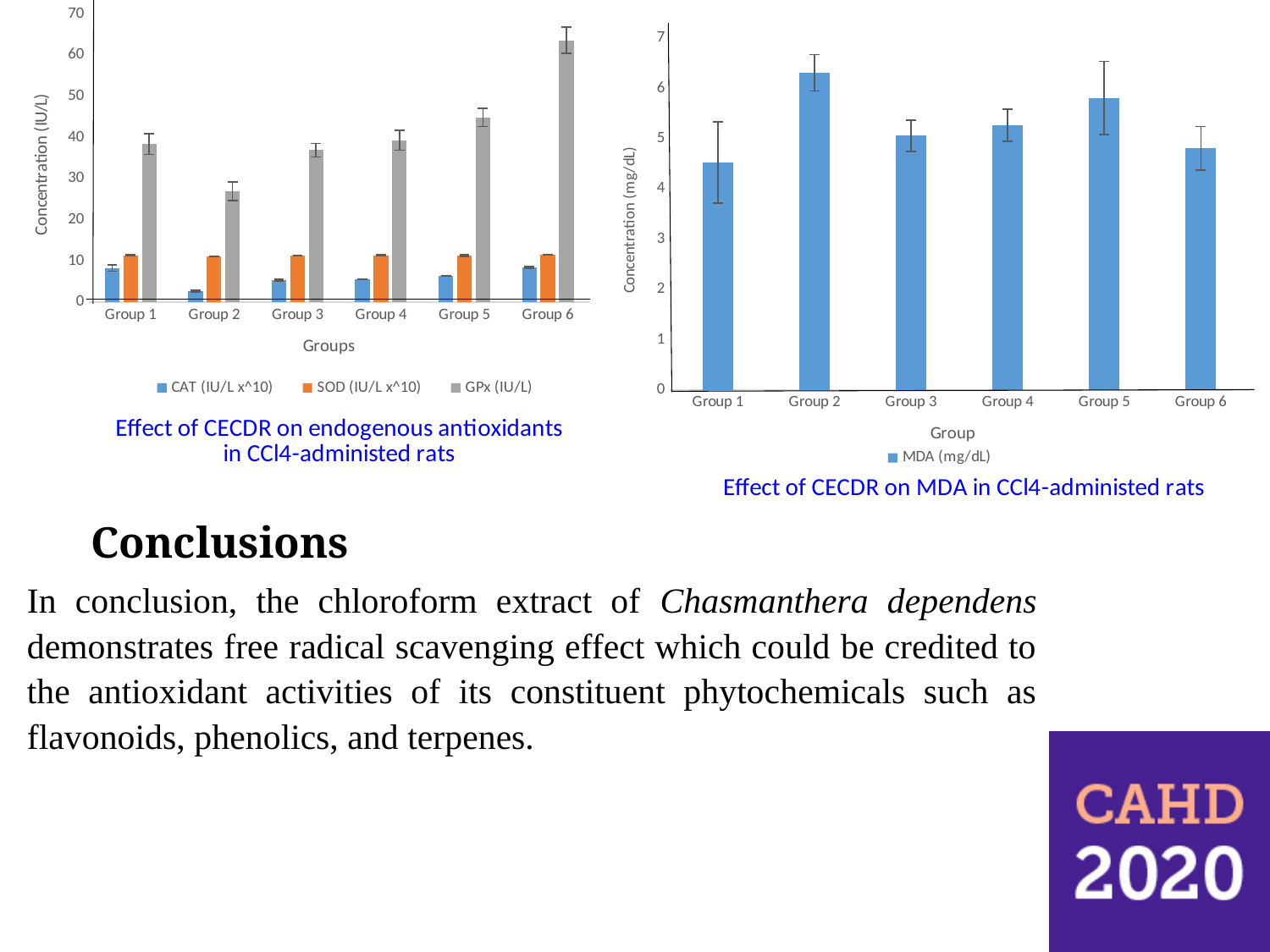
In the 'Effect of CECDR on MDA in CCl4-administed rats' chart, which group has the highest MDA (mg/dL) value? Group 2 In the 'Effect of CECDR on endogenous antioxidants in CCl4-administed rats' chart, which group has the lowest GPx (IU/L) value? Group 2 In the 'Effect of CECDR on endogenous antioxidants in CCl4-administed rats' chart, is the CAT (IU/L x^10) value for Group 2 greater or less than 10? less In the 'Effect of CECDR on endogenous antioxidants in CCl4-administed rats' chart, which group has the highest GPx (IU/L) value? Group 6 In the 'Effect of CECDR on MDA in CCl4-administed rats' chart, which is larger, the MDA value for Group 2 or for Group 3? Group 2 How many groups are shown on the x axis of the 'Effect of CECDR on endogenous antioxidants in CCl4-administed rats' chart? 6 In the 'Effect of CECDR on endogenous antioxidants in CCl4-administed rats' chart, is the GPx (IU/L) value for Group 6 greater or less than 60? greater What kind of chart is the 'Effect of CECDR on endogenous antioxidants in CCl4-administed rats' chart? bar chart In the 'Effect of CECDR on endogenous antioxidants in CCl4-administed rats' chart, what is the y-axis label? Concentration (IU/L) How many series does the legend list in the 'Effect of CECDR on endogenous antioxidants in CCl4-administed rats' chart? 3 In the 'Effect of CECDR on MDA in CCl4-administed rats' chart, is the MDA (mg/dL) value for Group 2 greater or less than 6? greater In the 'Effect of CECDR on MDA in CCl4-administed rats' chart, what series does the legend list? MDA (mg/dL)